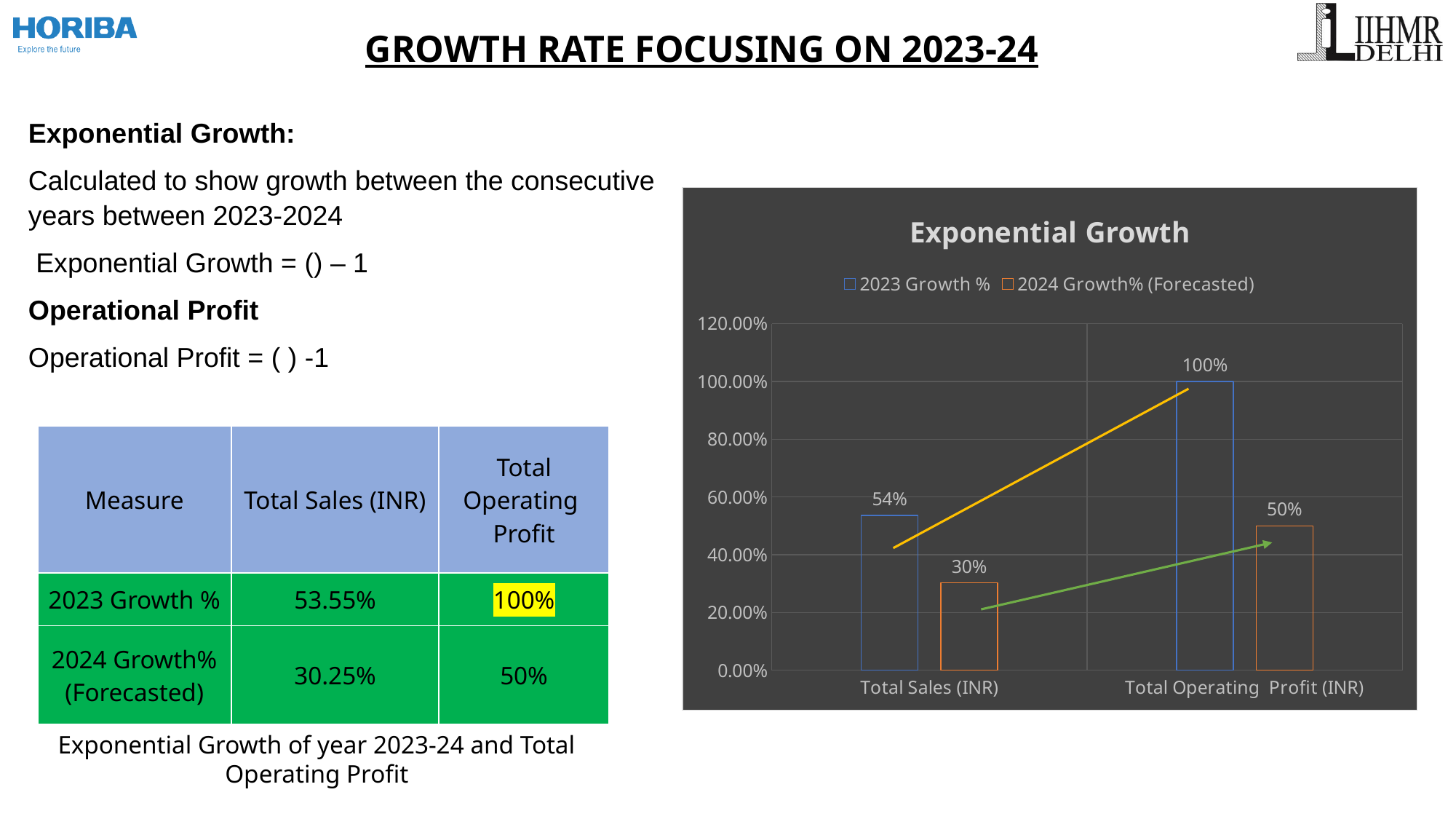
What is the 2023 Growth % value for Total Operating Profit (INR)? 100% What is the title of the chart? Exponential Growth Which is larger for Total Sales (INR): the 2023 Growth % or the 2024 Growth% (Forecasted)? 2023 Growth % What is the 2023 Growth % value for Total Sales (INR)? 54% Which category has the highest 2023 Growth % value? Total Operating Profit (INR) What is the difference between the 2023 Growth % and the 2024 Growth% (Forecasted) for Total Operating Profit (INR)? 50% How many series does the chart legend list? 2 What is the 2024 Growth% (Forecasted) value for Total Operating Profit (INR)? 50% What is the 2024 Growth% (Forecasted) value for Total Sales (INR)? 30% How many categories are shown on the x axis of the chart? 2 What kind of chart is shown on the slide? bar chart Which category has the lowest 2024 Growth% (Forecasted) value? Total Sales (INR)